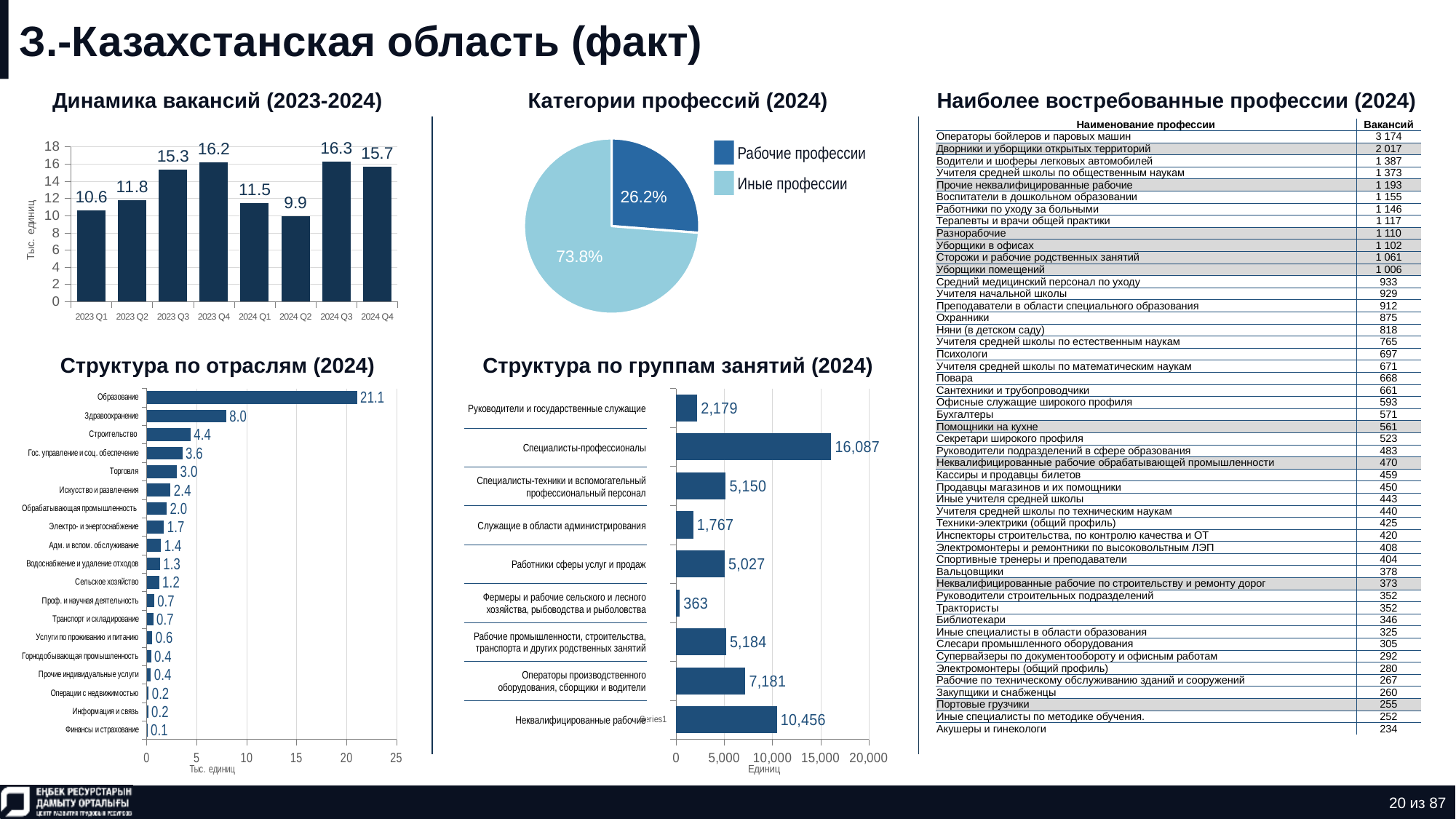
In the chart 'Динамика вакансий (2023-2024)', what is the difference between 2023 Q4 and 2023 Q1? 5.6 In the chart 'Структура по группам занятий (2024)', which category has the lowest value? Фермеры и рабочие сельского и лесного хозяйства, рыбоводства и рыболовства In the chart 'Структура по отраслям (2024)', which is larger: 'Строительство' or 'Торговля'? Строительство In the chart 'Структура по отраслям (2024)', which category has the highest value? Образование What kind of chart is 'Категории профессий (2024)'? Pie chart In the chart 'Динамика вакансий (2023-2024)', how many quarters are plotted? 8 In the chart 'Структура по отраслям (2024)', what is the value for 'Здравоохранение'? 8.0 In the chart 'Динамика вакансий (2023-2024)', what is the value for 2024 Q2? 9.9 In the chart 'Динамика вакансий (2023-2024)', which quarter has the highest value? 2024 Q3 In the chart 'Структура по группам занятий (2024)', how many categories are shown? 9 In the chart 'Структура по группам занятий (2024)', what is the value for 'Операторы производственного оборудования, сборщики и водители'? 7,181 In the chart 'Категории профессий (2024)', what share does 'Рабочие профессии' have? 26.2%